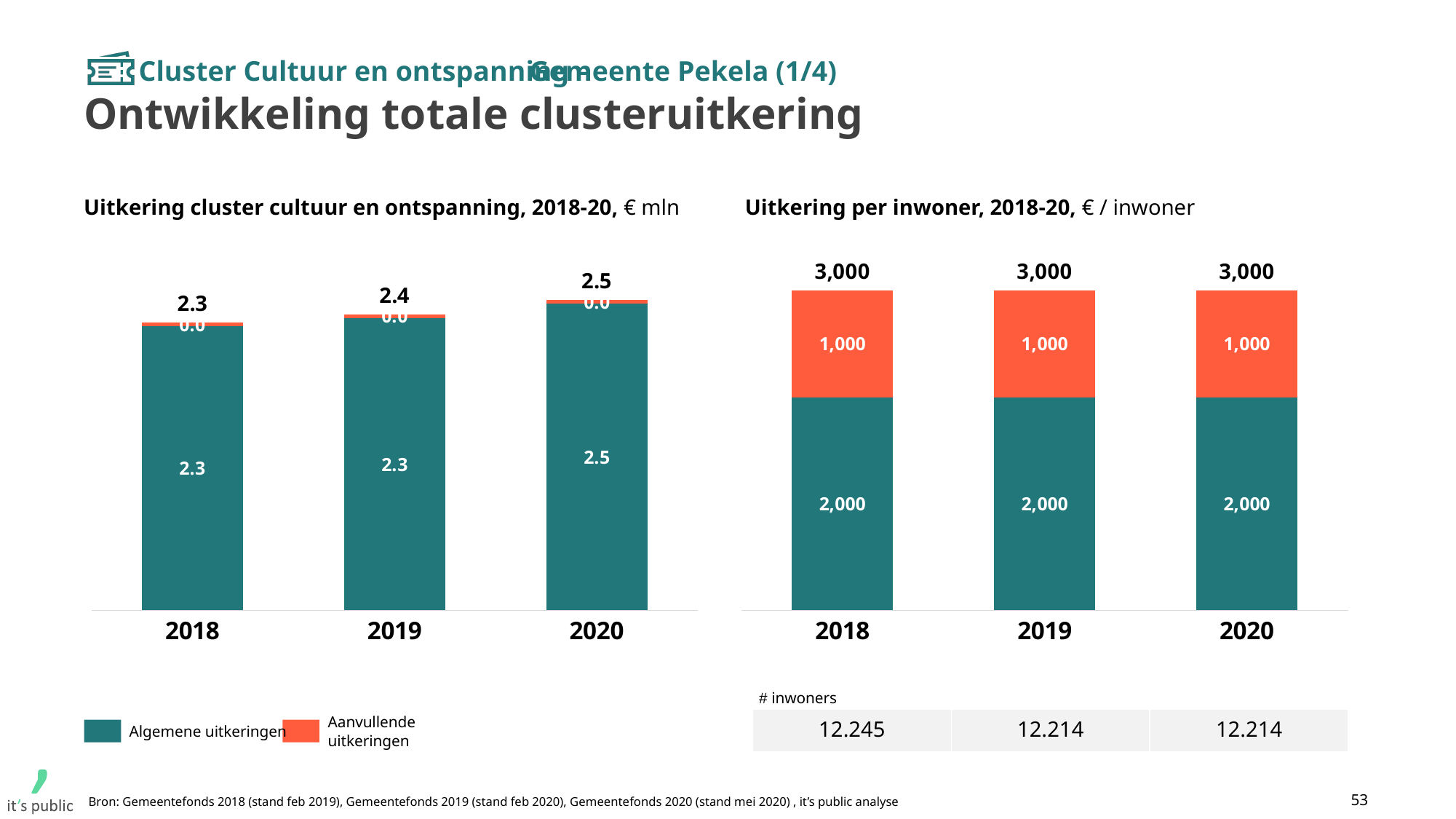
How many years are shown on the x axis of the right chart (Uitkering per inwoner)? 3 In the left chart (Uitkering cluster cultuur en ontspanning), do the total values rise or fall from 2018 to 2020? rise In the left chart (Uitkering cluster cultuur en ontspanning), what is the value of Algemene uitkeringen in 2019? 2.3 In the right chart (Uitkering per inwoner), what is the value of Algemene uitkeringen in 2020? 2,000 In the left chart (Uitkering cluster cultuur en ontspanning), what is the value of Aanvullende uitkeringen in 2018? 0.0 In the left chart (Uitkering cluster cultuur en ontspanning), what is the total uitkering for 2020? 2.5 In the left chart (Uitkering cluster cultuur en ontspanning), which year has the highest total uitkering? 2020 In the right chart (Uitkering per inwoner), what is the total of the stacked bar for 2018? 3,000 In the left chart (Uitkering cluster cultuur en ontspanning), what is the difference between the total for 2020 and the total for 2018? 0.2 In the left chart (Uitkering cluster cultuur en ontspanning), which year has the lowest total uitkering? 2018 In the right chart (Uitkering per inwoner), what is the value of Aanvullende uitkeringen in 2019? 1,000 How many series does the legend list for the charts on this slide? 2